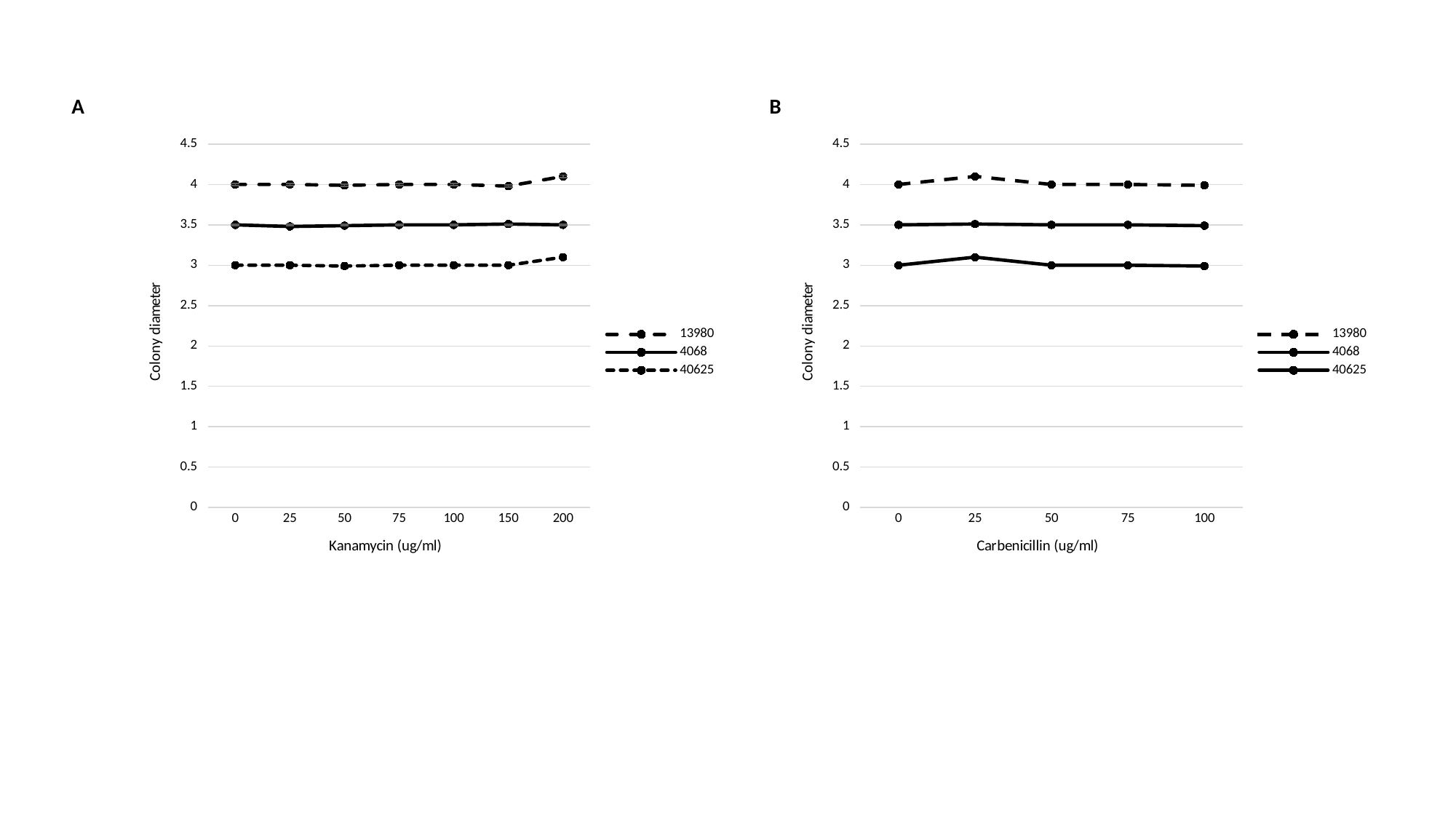
How many series does the legend of chart B (Carbenicillin) list? 3 In chart A (Kanamycin), is the colony diameter for series 4068 at 100 ug/ml greater or less than 3? greater In chart B (Carbenicillin), is the colony diameter for series 40625 at 50 ug/ml greater or less than 3.5? less How many x-axis points (Carbenicillin concentrations) are plotted in chart B? 5 What is the x-axis label of chart B? Carbenicillin (ug/ml) What kind of chart is chart A (Kanamycin)? line chart In chart A (Kanamycin), which series has the highest colony diameter across all concentrations? 13980 In chart B (Carbenicillin), which series has the lowest colony diameter across all concentrations? 40625 In chart B (Carbenicillin), which series has the larger colony diameter at 75 ug/ml: 13980 or 4068? 13980 In chart A (Kanamycin), which series has the larger colony diameter at 50 ug/ml: 4068 or 40625? 4068 What is the y-axis label of chart A? Colony diameter How many x-axis points (Kanamycin concentrations) are plotted in chart A? 7